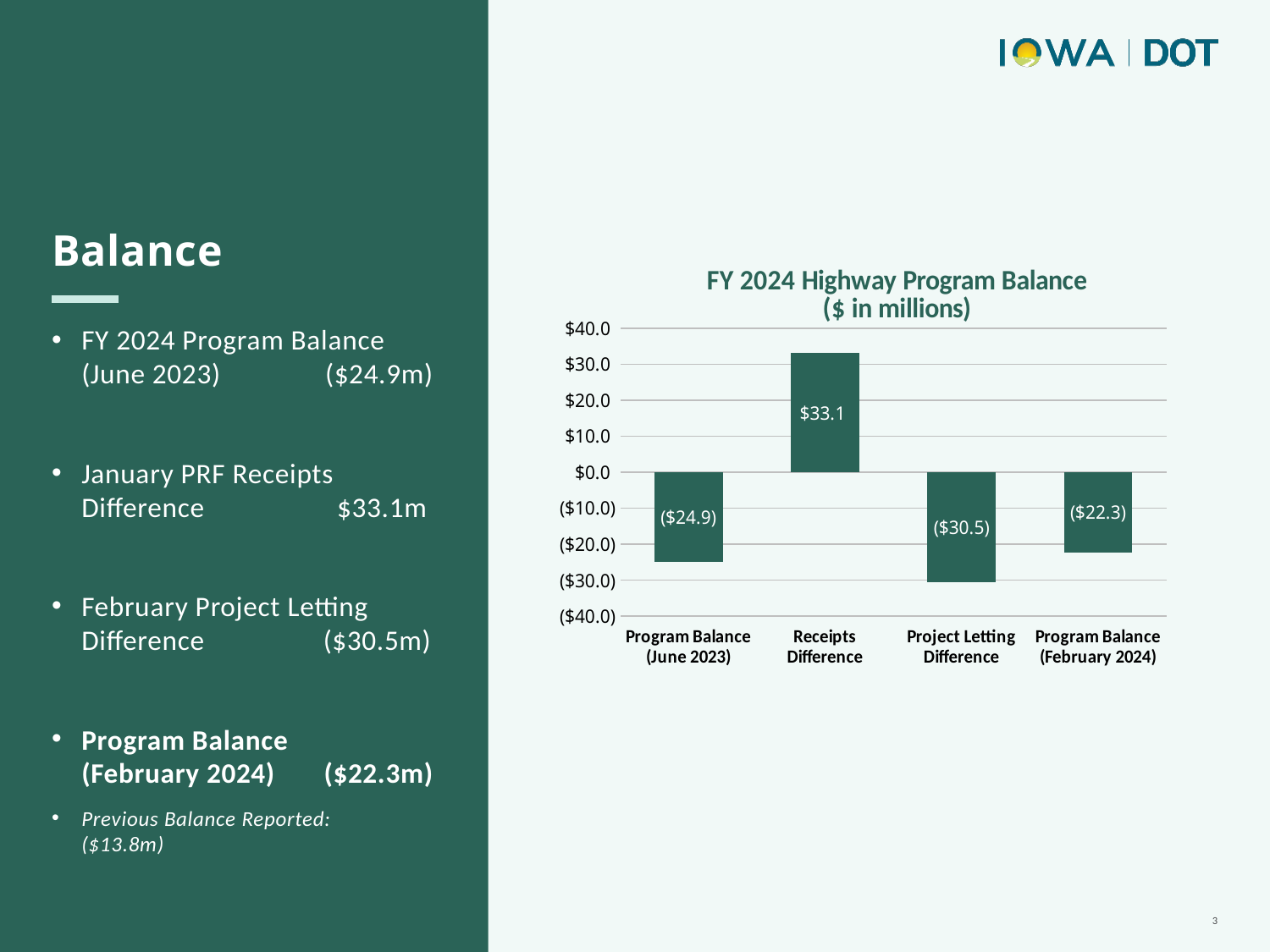
Which is larger, the value for Program Balance (June 2023) or the value for Program Balance (February 2024)? Program Balance (February 2024) Is the value for Receipts Difference greater or less than $30.0? greater What type of chart is shown on the slide? Bar chart Which category has the lowest value in the chart? Project Letting Difference What is the value for Receipts Difference in the FY 2024 Highway Program Balance chart? $33.1 Which category has the highest value in the chart? Receipts Difference What is the value for Project Letting Difference in the chart? ($30.5) What is the title of the chart? FY 2024 Highway Program Balance ($ in millions) What is the value for Program Balance (February 2024) in the chart? ($22.3) What is the difference between the Receipts Difference value and the Program Balance (February 2024) value? $55.4 What is the value for Program Balance (June 2023) in the chart? ($24.9) How many categories are shown in the chart? 4